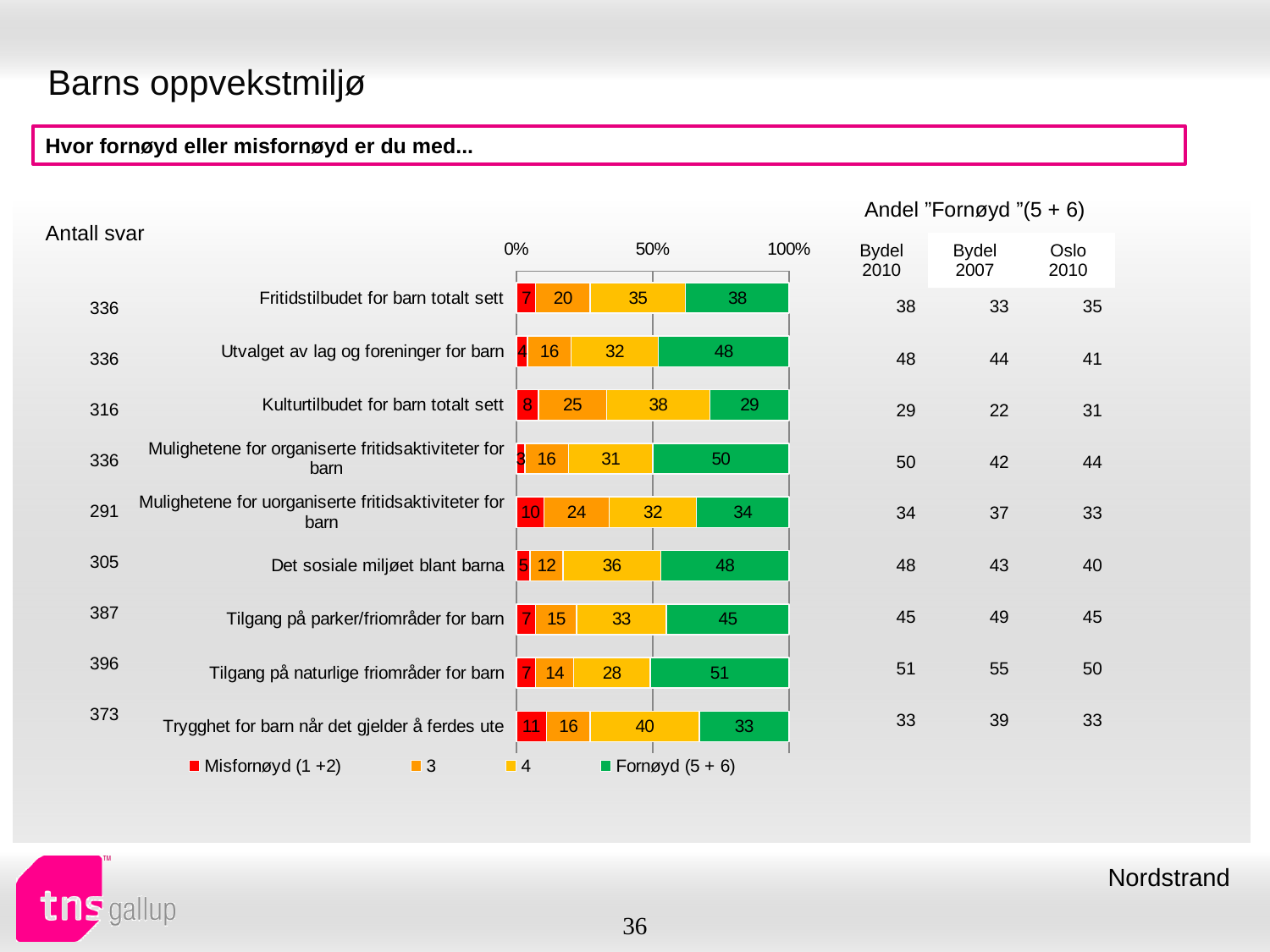
What type of chart is shown on the slide? Stacked bar chart What is the 'Fornøyd (5 + 6)' value for 'Tilgang på naturlige friområder for barn'? 51 Which category has the lowest 'Fornøyd (5 + 6)' value? Kulturtilbudet for barn totalt sett Which is larger: the 'Fornøyd (5 + 6)' value for 'Det sosiale miljøet blant barna' or for 'Tilgang på parker/friområder for barn'? Det sosiale miljøet blant barna How many series does the chart legend list? 4 What is the 'Misfornøyd (1 +2)' value for 'Trygghet for barn når det gjelder å ferdes ute'? 11 What is the difference between the 'Fornøyd (5 + 6)' values for 'Mulighetene for organiserte fritidsaktiviteter for barn' and 'Mulighetene for uorganiserte fritidsaktiviteter for barn'? 16 Which category has the highest 'Fornøyd (5 + 6)' value? Tilgang på naturlige friområder for barn Which category has the highest 'Misfornøyd (1 +2)' value? Trygghet for barn når det gjelder å ferdes ute What is the value of series '3' for 'Kulturtilbudet for barn totalt sett'? 25 How many categories (questions) are plotted in the chart? 9 What is the total of the stacked bar for 'Fritidstilbudet for barn totalt sett'? 100